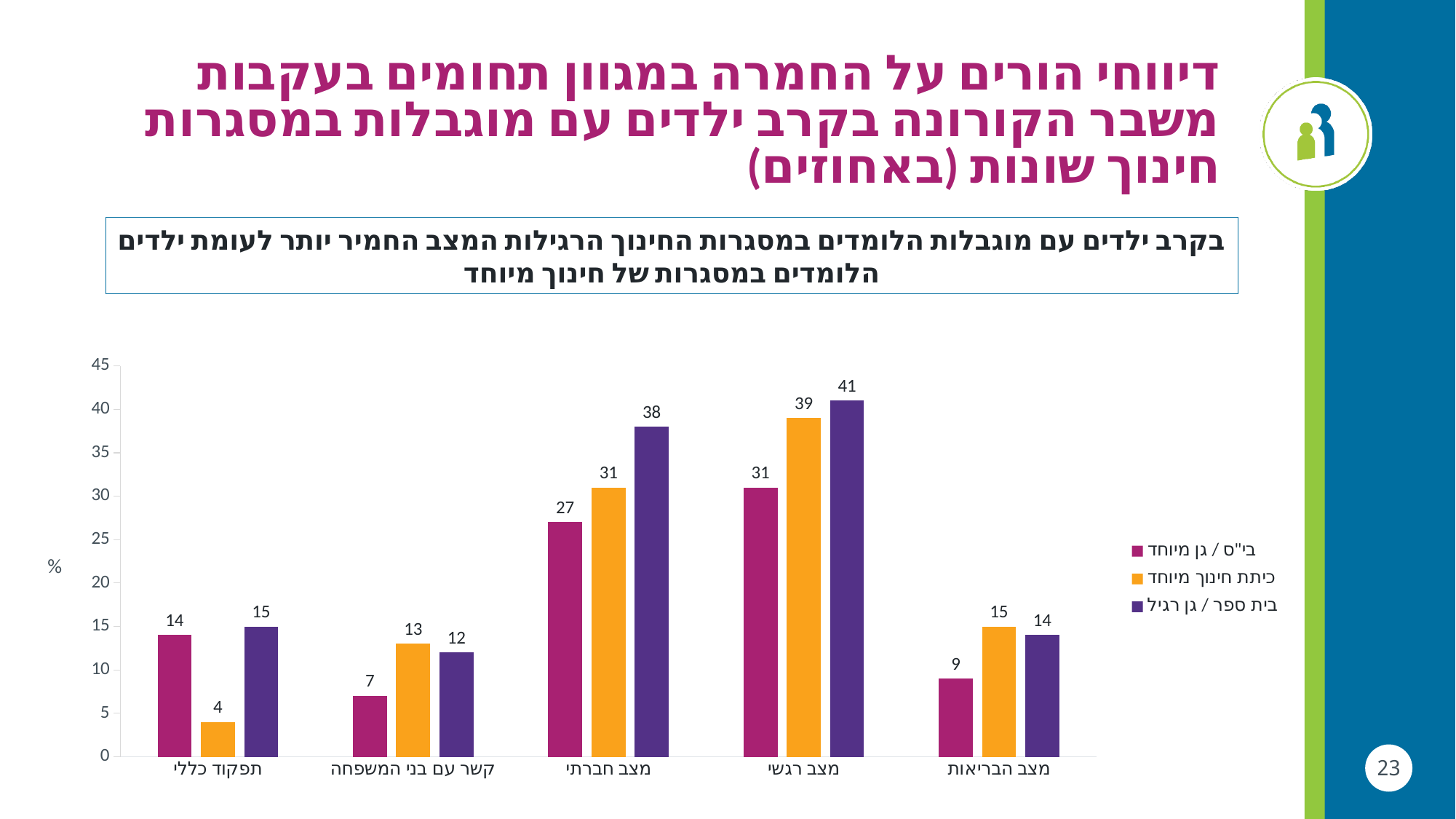
What is the value for בי"ס / גן מיוחד in the מצב חברתי category? 27 What is the value for בי"ס / גן מיוחד in the מצב הבריאות category? 9 Is the value for כיתת חינוך מיוחד in the מצב רגשי category greater or less than 35? greater What is the value for בית ספר / גן רגיל in the מצב רגשי category? 41 What is the value for כיתת חינוך מיוחד in the תפקוד כללי category? 4 What kind of chart is shown on the slide? bar chart Which category has the highest value for the בית ספר / גן רגיל series? מצב רגשי What is the difference between the בית ספר / גן רגיל and בי"ס / גן מיוחד values in the מצב חברתי category? 11 How many categories are shown on the x axis of the chart? 5 Which category has the lowest value for the כיתת חינוך מיוחד series? תפקוד כללי How many series does the chart legend list? 3 In the קשר עם בני המשפחה category, which series has the larger value: כיתת חינוך מיוחד or בי"ס / גן מיוחד? כיתת חינוך מיוחד